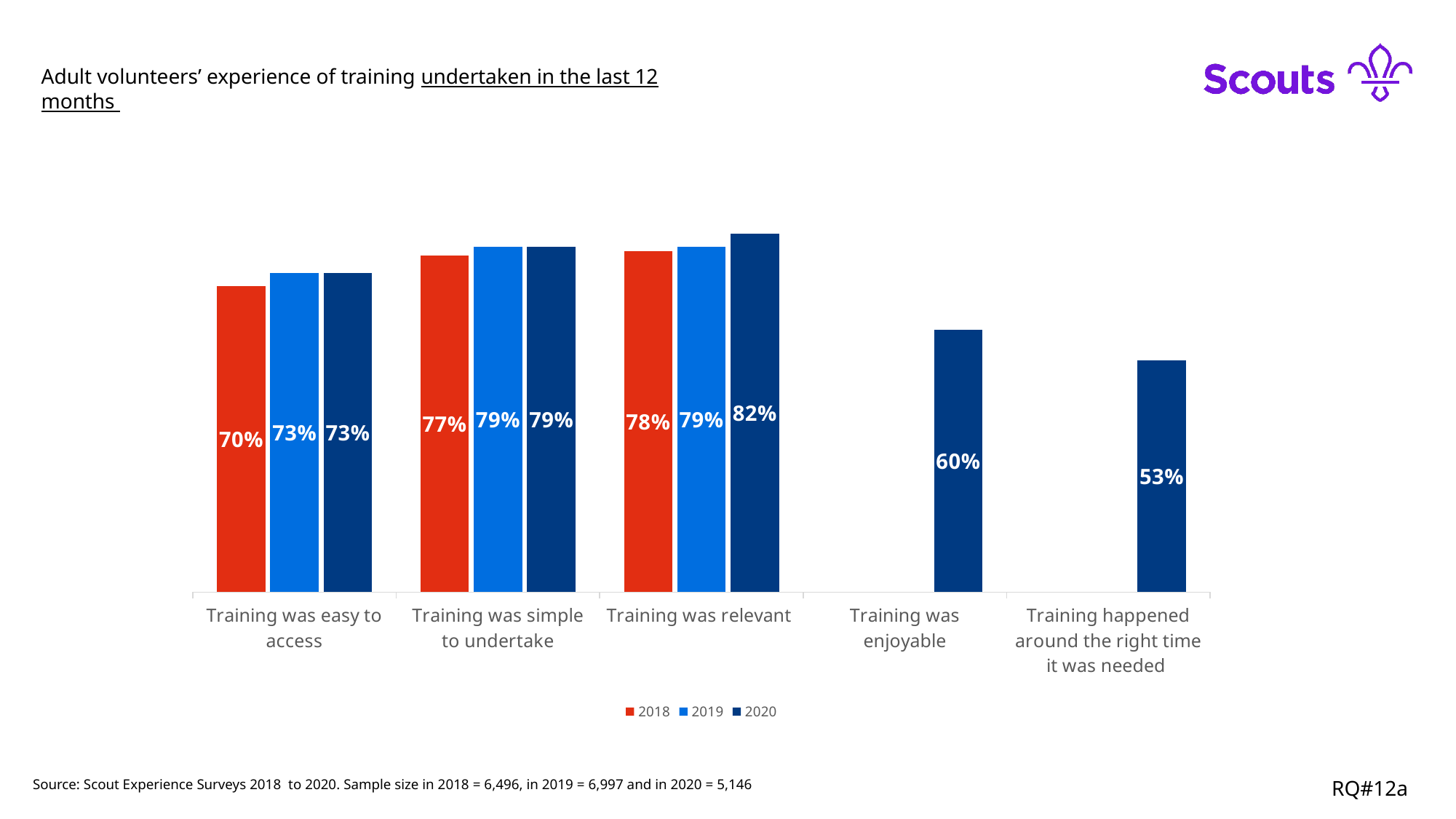
Which is larger: the 2020 value for 'Training was enjoyable' or the 2020 value for 'Training happened around the right time it was needed'? Training was enjoyable How many categories are shown on the x axis? 5 What was the 2020 value for 'Training was enjoyable'? 60% What was the 2018 value for 'Training was easy to access'? 70% What was the 2019 value for 'Training was simple to undertake'? 79% What is the difference between the 2020 and 2018 values for 'Training was relevant'? 4 percentage points What was the 2020 value for 'Training was relevant'? 82% What kind of chart is shown on the slide? Bar chart Which category has the highest 2020 value? Training was relevant Which category has the lowest 2020 value? Training happened around the right time it was needed How many series does the legend list? 3 Did the value for 'Training was easy to access' rise or fall from 2018 to 2019? Rise